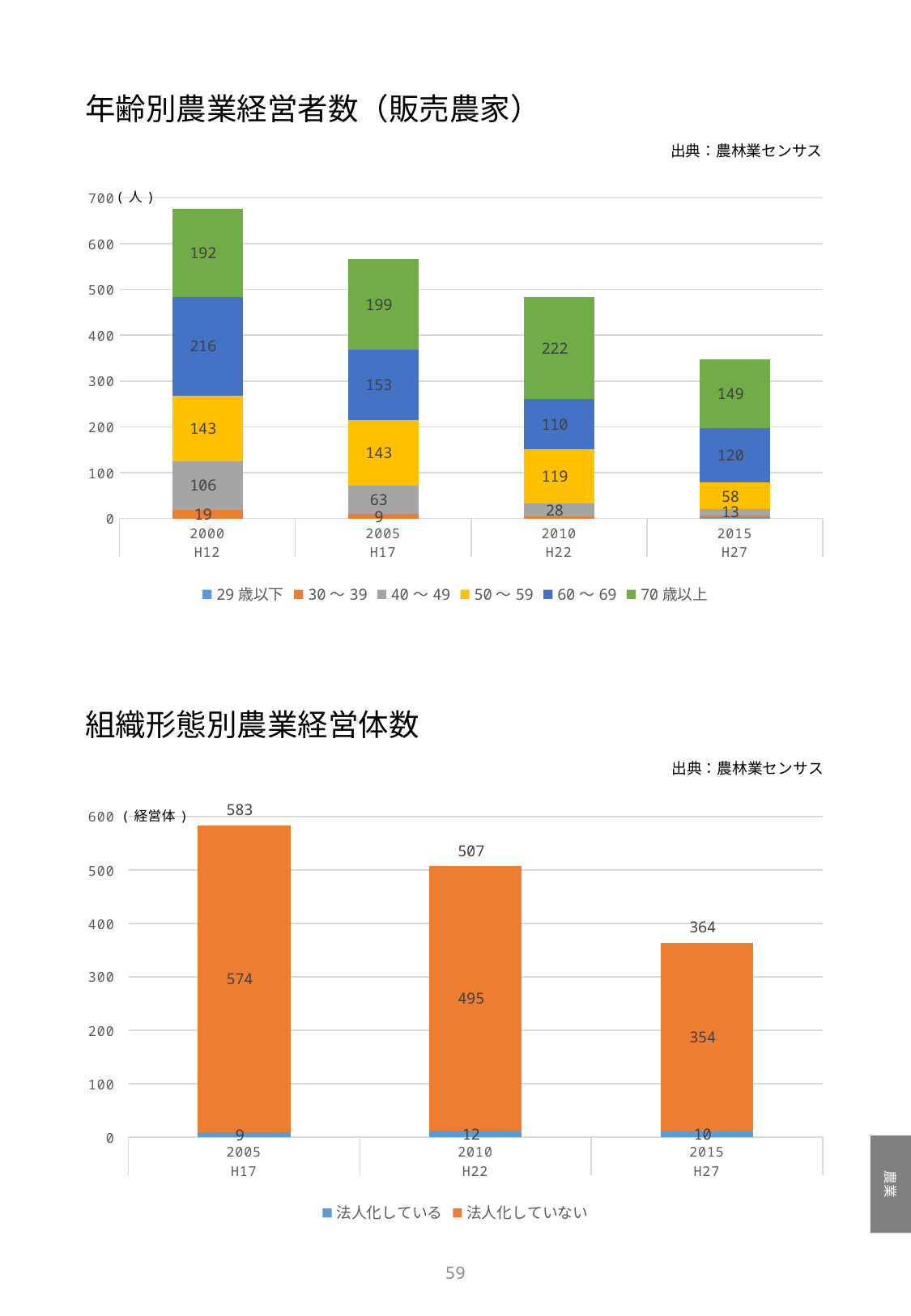
In the top chart (年齢別農業経営者数), what is the value for 50〜59 in 2015 (H27)? 58 In the top chart (年齢別農業経営者数), how many series does the legend list? 6 In the bottom chart (組織形態別農業経営体数), what is the total for 2005 (H17)? 583 What kind of chart is the bottom chart (組織形態別農業経営体数)? Stacked bar chart In the top chart (年齢別農業経営者数), which is larger: the 60〜69 value in 2005 (H17) or the 60〜69 value in 2010 (H22)? 2005 (H17) In the top chart (年齢別農業経営者数), is the total stacked bar for 2015 (H27) greater or less than 400? less In the top chart (年齢別農業経営者数), what is the difference between the 70歳以上 values for 2010 (H22) and 2015 (H27)? 73 In the bottom chart (組織形態別農業経営体数), which year has the lowest total? 2015 (H27) In the top chart (年齢別農業経営者数), what is the value for 70歳以上 in 2010 (H22)? 222 In the top chart (年齢別農業経営者数), what is the value for 60〜69 in 2000 (H12)? 216 In the bottom chart (組織形態別農業経営体数), what is the value for 法人化している in 2010 (H22)? 12 In the bottom chart (組織形態別農業経営体数), what is the difference between the 法人化していない values for 2005 (H17) and 2015 (H27)? 220